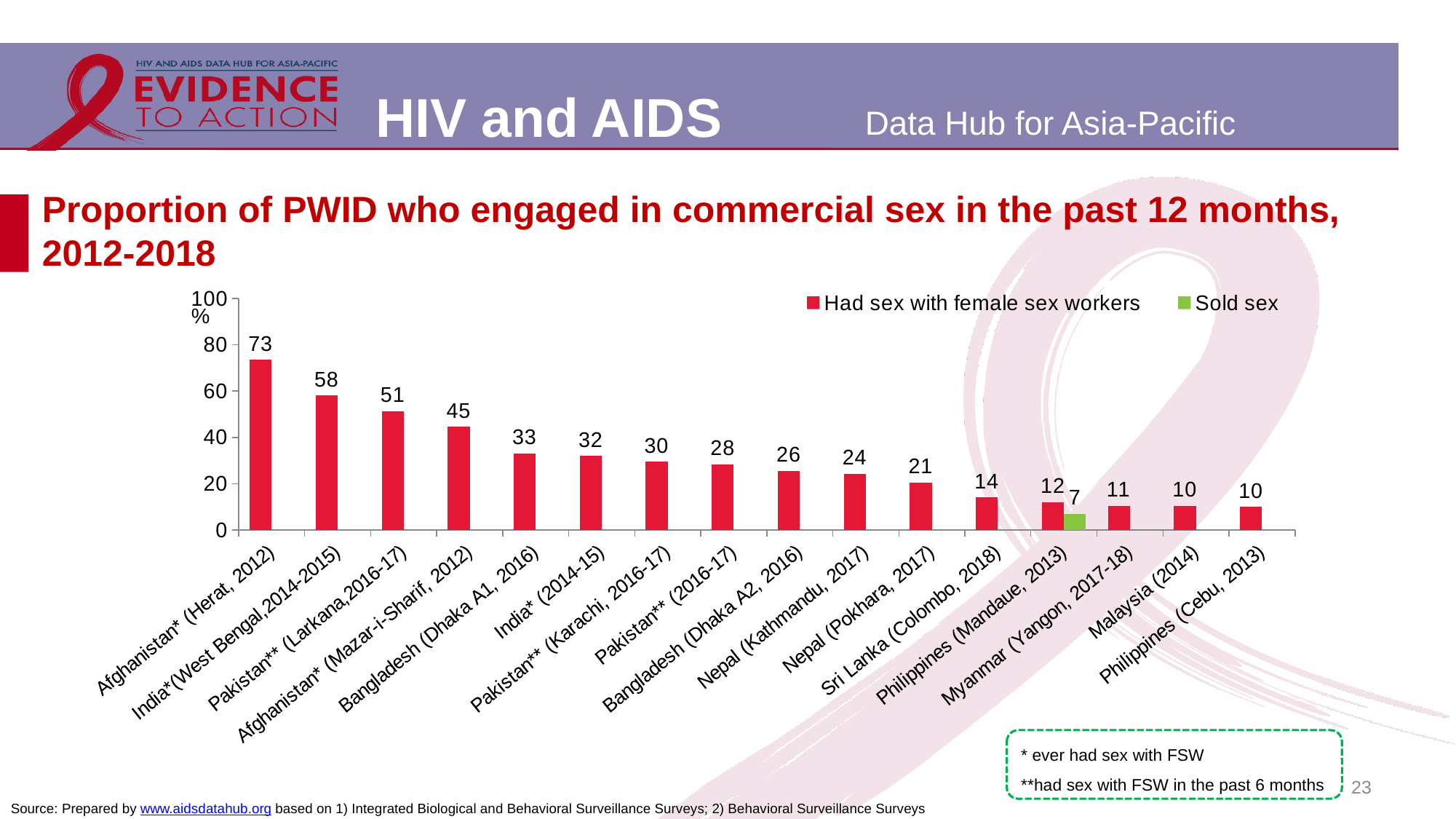
Which category has the highest value for 'Had sex with female sex workers'? Afghanistan* (Herat, 2012) What is the value for 'Had sex with female sex workers' for Nepal (Kathmandu, 2017)? 24 Is the 'Had sex with female sex workers' value for Afghanistan* (Mazar-i-Sharif, 2012) greater or less than 40? greater What type of chart is shown on the slide? Bar chart How many categories are shown on the x axis? 16 What is the 'Sold sex' value for Philippines (Mandaue, 2013)? 7 How many series does the legend list? 2 Which category is the only one with a 'Sold sex' bar? Philippines (Mandaue, 2013) What is the difference between the 'Had sex with female sex workers' values for India*(West Bengal,2014-2015) and Pakistan** (Larkana,2016-17)? 7 What is the value for 'Had sex with female sex workers' for Afghanistan* (Herat, 2012)? 73 Which is larger for 'Had sex with female sex workers': Bangladesh (Dhaka A1, 2016) or Bangladesh (Dhaka A2, 2016)? Bangladesh (Dhaka A1, 2016) Do the 'Had sex with female sex workers' values generally rise or fall from left to right along the x axis? Fall